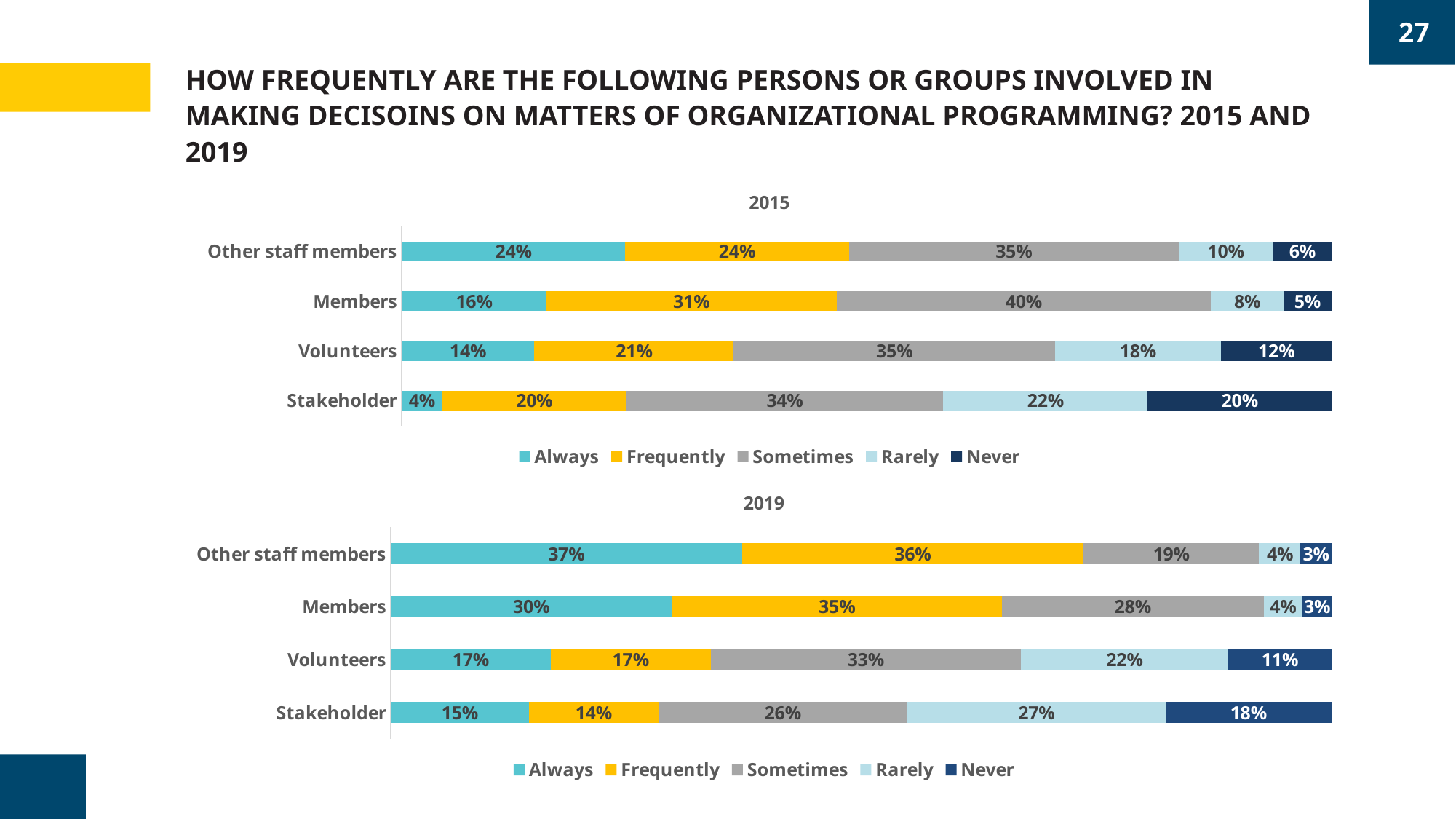
In the 2019 chart, what is the 'Rarely' value for Stakeholder? 27% In the 2019 chart, what is the difference between the 'Always' values for Other staff members and Volunteers? 20% In the 2015 chart, which is larger: the 'Rarely' value for Volunteers or the 'Rarely' value for Members? Volunteers How many series does the legend of the 2015 chart list? 5 In the 2015 chart, what percentage of Members are 'Sometimes' involved? 40% In the 2015 chart, which group has the highest 'Always' value? Other staff members In the 2015 chart, what is the 'Never' value for Stakeholder? 20% In the 2019 chart, which group has the lowest 'Frequently' value? Stakeholder In the 2015 chart, what is the total of the 'Always' and 'Frequently' values for Members? 47% In the 2019 chart, what percentage of Other staff members are 'Always' involved? 37% What type of chart is the 2015 chart? Stacked bar chart How many groups are shown in the 2019 chart? 4